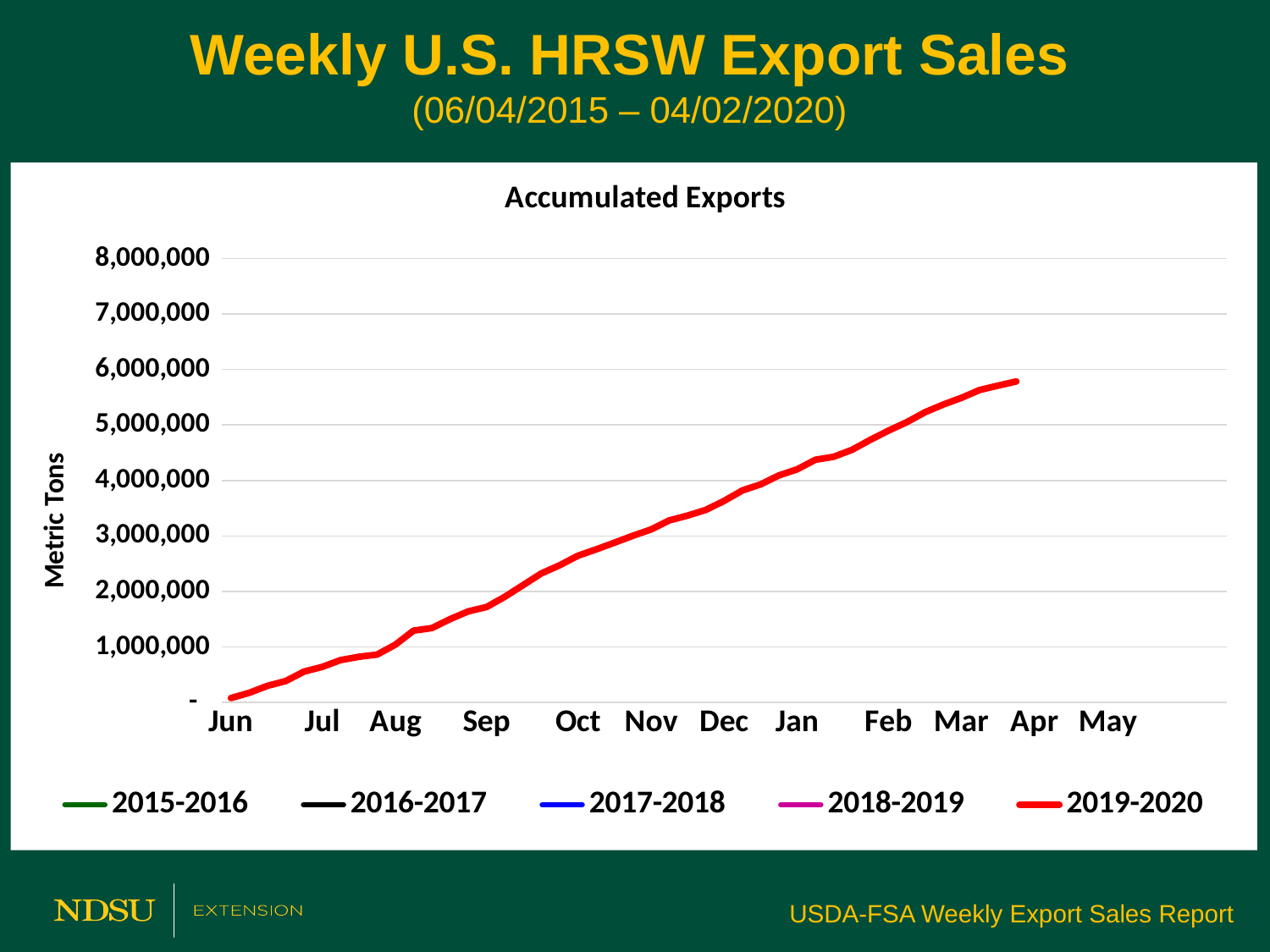
Is the 2019-2020 value at Sep greater or less than 2,000,000? less What is the title of the chart? Accumulated Exports Is the 2019-2020 value at Mar greater or less than 5,000,000? greater Is the 2019-2020 value at Dec greater or less than 3,000,000? greater What kind of chart is shown on the slide? line chart How many month labels are shown on the x axis? 12 How many series does the legend list? 5 What is the label on the y axis? Metric Tons Which is larger for 2019-2020: the value at Oct or the value at Jan? Jan Does the 2019-2020 accumulated exports line rise or fall from Jun to Apr? rise